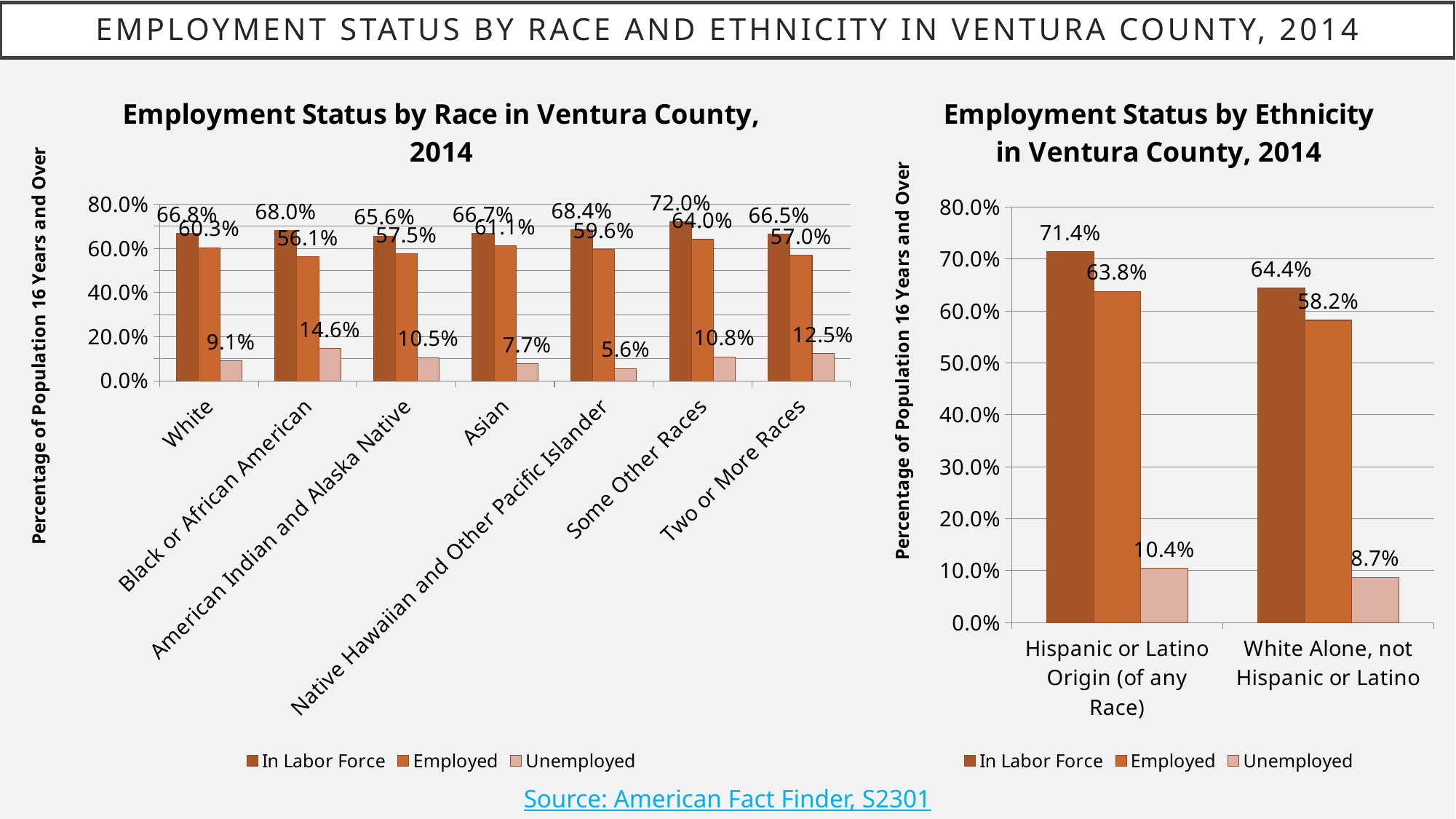
In the 'Employment Status by Ethnicity in Ventura County, 2014' chart, what is the Unemployed value for White Alone, not Hispanic or Latino? 8.7% How many series does the legend of the 'Employment Status by Ethnicity in Ventura County, 2014' chart list? 3 In the 'Employment Status by Ethnicity in Ventura County, 2014' chart, what is the difference between the Employed values for Hispanic or Latino Origin (of any Race) and White Alone, not Hispanic or Latino? 5.6% In the 'Employment Status by Race in Ventura County, 2014' chart, what is the Unemployed value for Black or African American? 14.6% In the 'Employment Status by Race in Ventura County, 2014' chart, which race has the highest In Labor Force value? Some Other Races In the 'Employment Status by Ethnicity in Ventura County, 2014' chart, which group has the larger In Labor Force value? Hispanic or Latino Origin (of any Race) In the 'Employment Status by Race in Ventura County, 2014' chart, how many race categories are shown? 7 In the 'Employment Status by Ethnicity in Ventura County, 2014' chart, what is the Employed value for Hispanic or Latino Origin (of any Race)? 63.8% In the 'Employment Status by Race in Ventura County, 2014' chart, what is the difference between the In Labor Force and Employed values for White? 6.5% In the 'Employment Status by Race in Ventura County, 2014' chart, which race has the lowest Unemployed value? Native Hawaiian and Other Pacific Islander In the 'Employment Status by Race in Ventura County, 2014' chart, what is the In Labor Force value for Asian? 66.7% What type of chart is the 'Employment Status by Race in Ventura County, 2014' chart? Bar chart